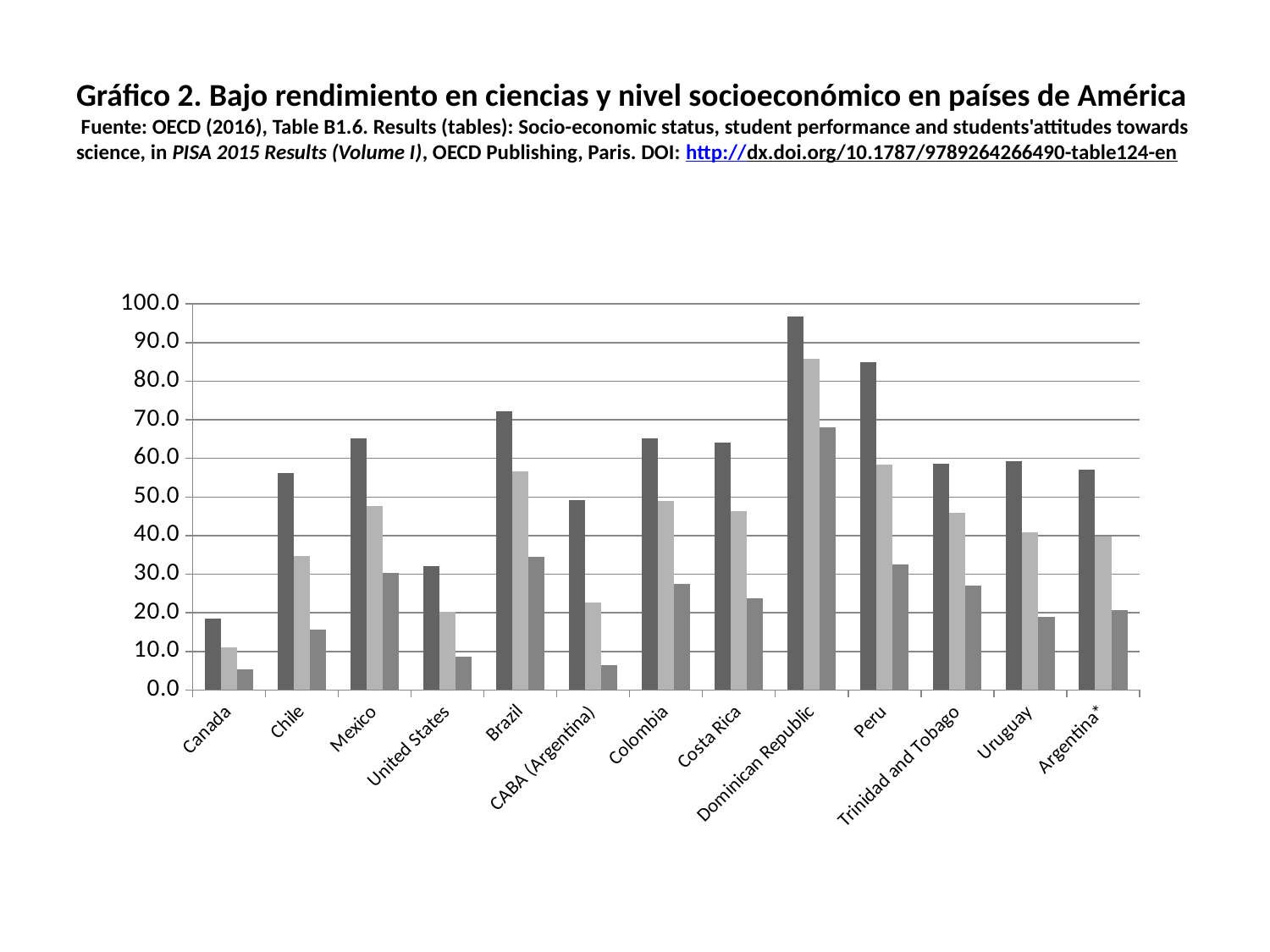
Is the first (darkest) bar for Peru greater or less than 80? greater Which country has the lowest bars on the chart? Canada Is the first (darkest) bar for Canada greater or less than 20? less Which country has the tallest bar on the chart? Dominican Republic Is the third (rightmost) bar for United States greater or less than 10? less Which has the taller first (darkest) bar, Brazil or Mexico? Brazil How many bars are plotted for each country on the chart? 3 What is the title of the chart on the slide? Gráfico 2. Bajo rendimiento en ciencias y nivel socioeconómico en países de América How many countries or regions are shown on the x axis of the chart? 13 What kind of chart is shown on the slide? bar chart